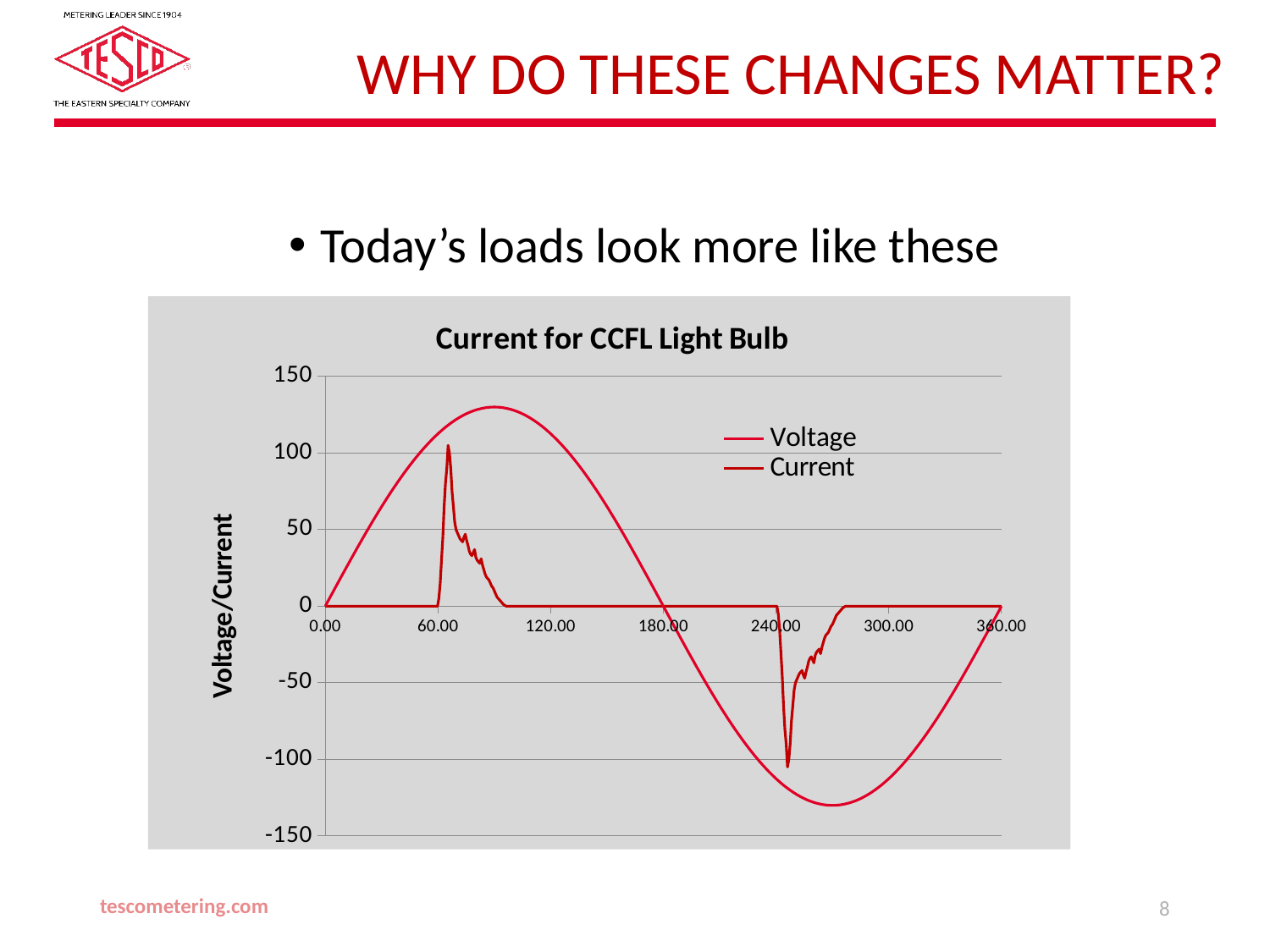
Is the peak value of the Current series greater or less than 150? less Is the lowest value of the Voltage series greater or less than -100? less Does the Voltage series rise or fall between 0.00 and 60.00 on the x axis? rise Is the value of the Current series at 120.00 greater or less than 50? less What is the label on the vertical axis of the chart? Voltage/Current What is the title of the chart? Current for CCFL Light Bulb What kind of chart is shown on the slide? Line chart Which series reaches a higher peak value, Voltage or Current? Voltage Does the Voltage series rise or fall between 120.00 and 180.00 on the x axis? fall How many series does the legend list? 2 What is the value of the Voltage series at 180.00? 0